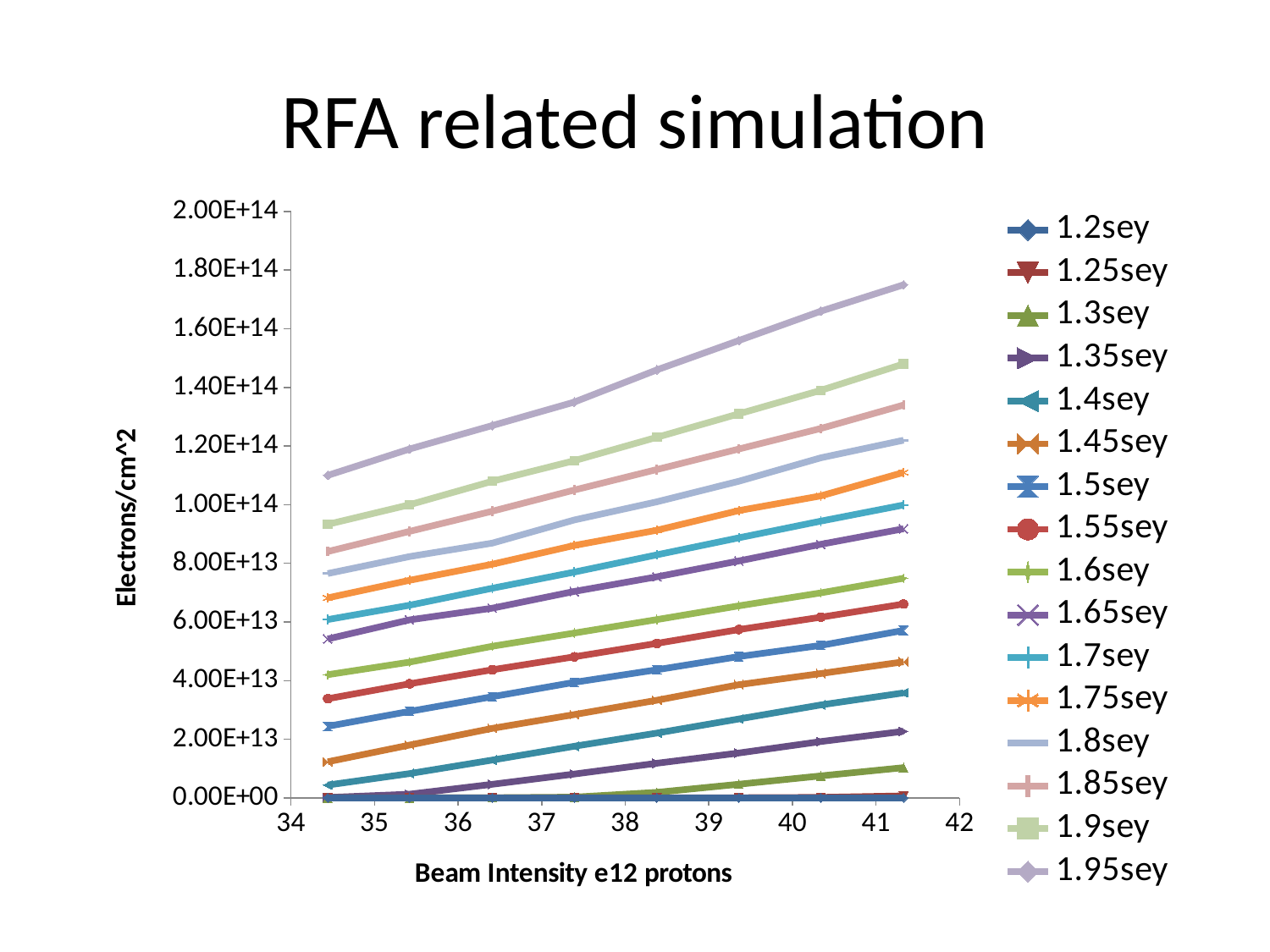
How many series does the legend list? 16 What kind of chart is shown on the slide? line chart Is the value for 1.6sey at the highest beam intensity greater or less than 8.00E+13? less Is the value for 1.95sey at the highest beam intensity greater or less than 1.60E+14? greater Is the value for 1.9sey at the lowest beam intensity greater or less than 1.00E+14? less Which series has the highest values across the chart? 1.95sey What is the title of the chart? RFA related simulation Do the values for the 1.95sey series rise or fall as beam intensity increases? rise At the highest beam intensity, which series has the larger value, 1.8sey or 1.5sey? 1.8sey What is the label of the x axis? Beam Intensity e12 protons At the lowest beam intensity, which series has the larger value, 1.95sey or 1.3sey? 1.95sey